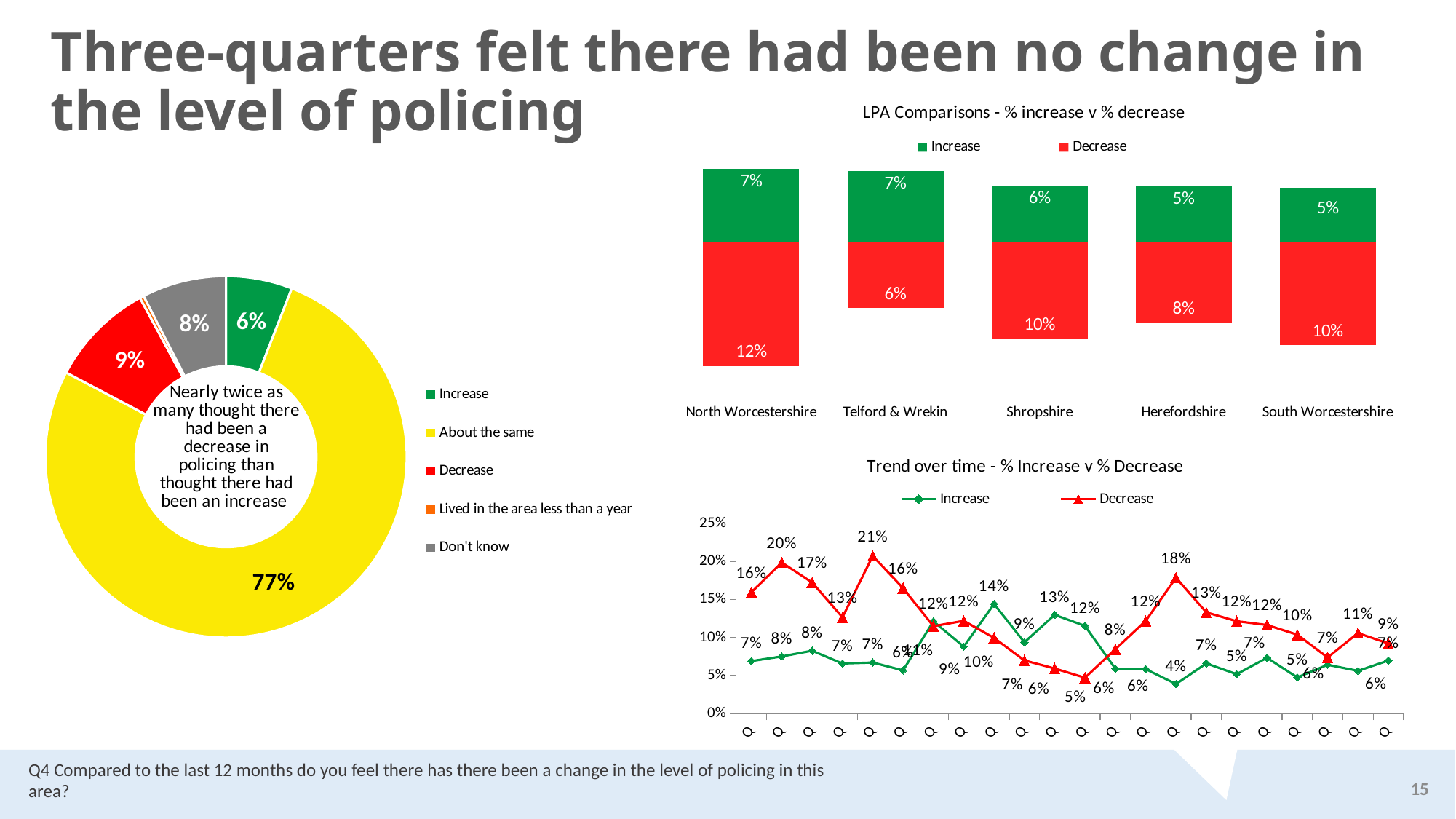
In the 'LPA Comparisons - % increase v % decrease' chart, how many LPAs are shown? 5 In the donut chart on the left, how many entries does the legend list? 5 In the 'LPA Comparisons - % increase v % decrease' chart, what is the Decrease value for North Worcestershire? 12% In the donut chart on the left, what percentage of respondents said 'About the same'? 77% In the 'LPA Comparisons - % increase v % decrease' chart, what is the Increase value for Herefordshire? 5% What kind of chart is 'Trend over time - % Increase v % Decrease'? Line chart In the donut chart on the left, which category has the largest share? About the same In the donut chart on the left, what percentage of respondents said 'Decrease'? 9% In the 'LPA Comparisons - % increase v % decrease' chart, what is the difference between the Decrease and Increase values for South Worcestershire? 5% In the 'LPA Comparisons - % increase v % decrease' chart, which LPA has the lowest Decrease value? Telford & Wrekin In the 'Trend over time - % Increase v % Decrease' chart, what is the highest value reached by the Decrease series? 21% In the 'LPA Comparisons - % increase v % decrease' chart, what is the total of the stacked bar for Shropshire? 16%